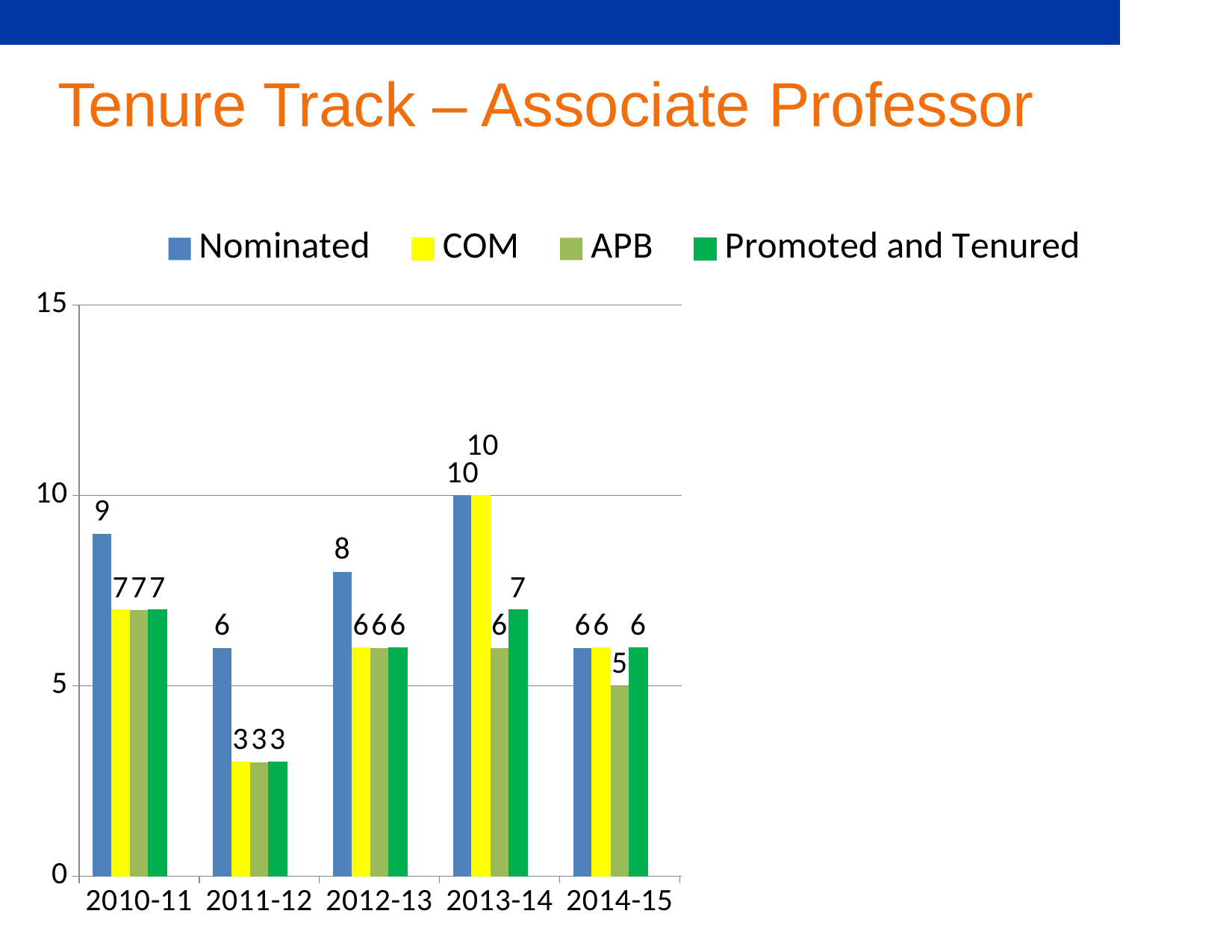
What is the difference between the Nominated and Promoted and Tenured values for 2010-11? 2 In which year is the Nominated value highest? 2013-14 What is the APB value for 2014-15? 5 What is the Nominated value for 2013-14? 10 What is the title of the slide? Tenure Track – Associate Professor What is the COM value for 2011-12? 3 Which is larger for 2013-14, the COM value or the APB value? COM What kind of chart is shown on the slide? Bar chart How many series does the legend list? 4 How many years are shown on the x axis? 5 In which year is the Promoted and Tenured value lowest? 2011-12 What is the Promoted and Tenured value for 2013-14? 7